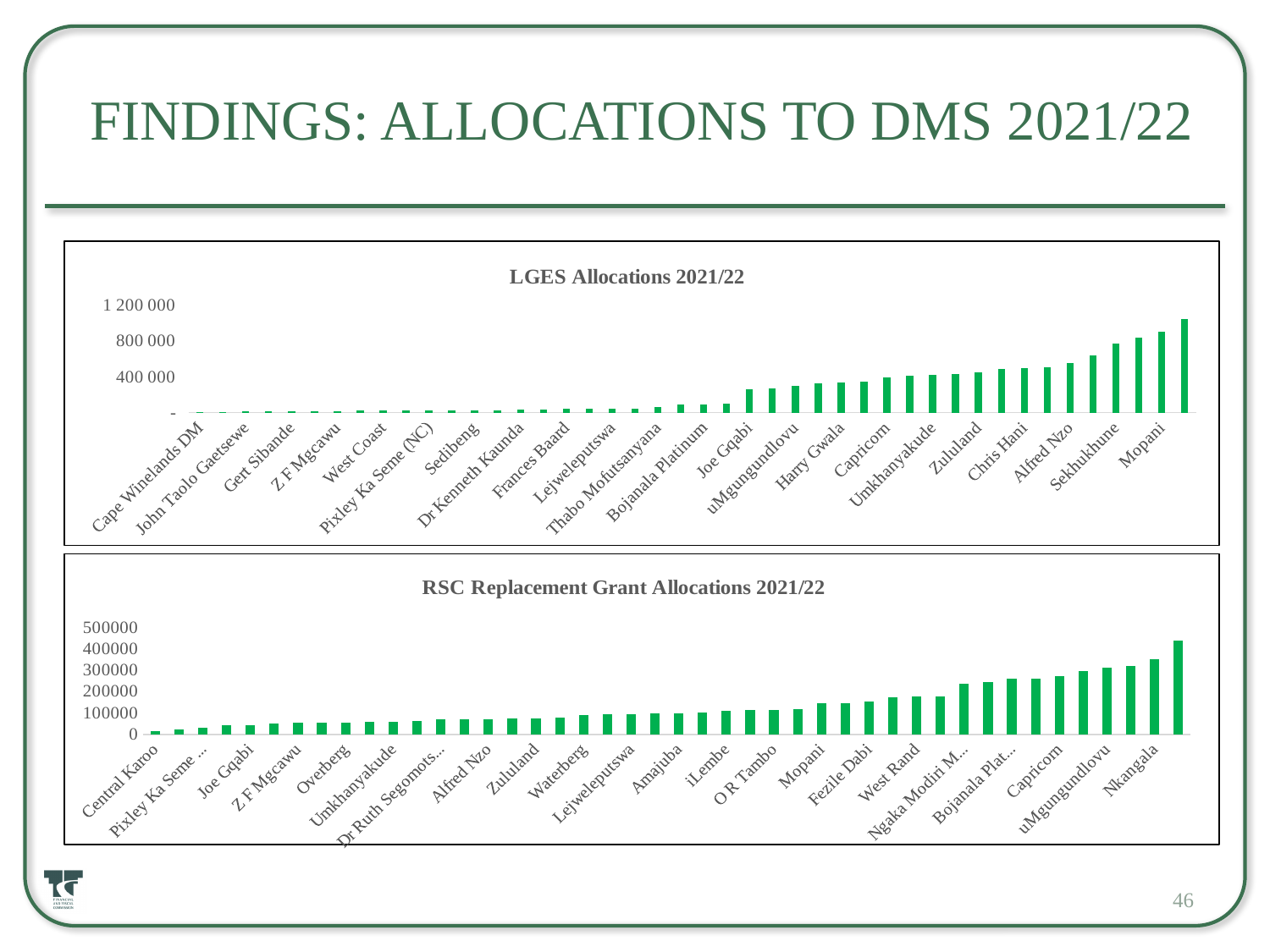
In the LGES Allocations 2021/22 chart, is the value for Joe Gqabi greater or less than 400 000? less What kind of chart is the RSC Replacement Grant Allocations 2021/22 chart? bar chart In the LGES Allocations 2021/22 chart, which district has the lowest allocation? Cape Winelands DM In the RSC Replacement Grant Allocations 2021/22 chart, which has the larger allocation, Mopani or Zululand? Mopani In the RSC Replacement Grant Allocations 2021/22 chart, which district has the lowest allocation? Central Karoo In the RSC Replacement Grant Allocations 2021/22 chart, is the value for Nkangala greater or less than 400000? less What kind of chart is the LGES Allocations 2021/22 chart? bar chart In the LGES Allocations 2021/22 chart, which has the larger allocation, Alfred Nzo or Harry Gwala? Alfred Nzo In the LGES Allocations 2021/22 chart, is the value for Mopani greater or less than 800 000? greater In the LGES Allocations 2021/22 chart, do the values rise or fall from left to right along the x axis? rise